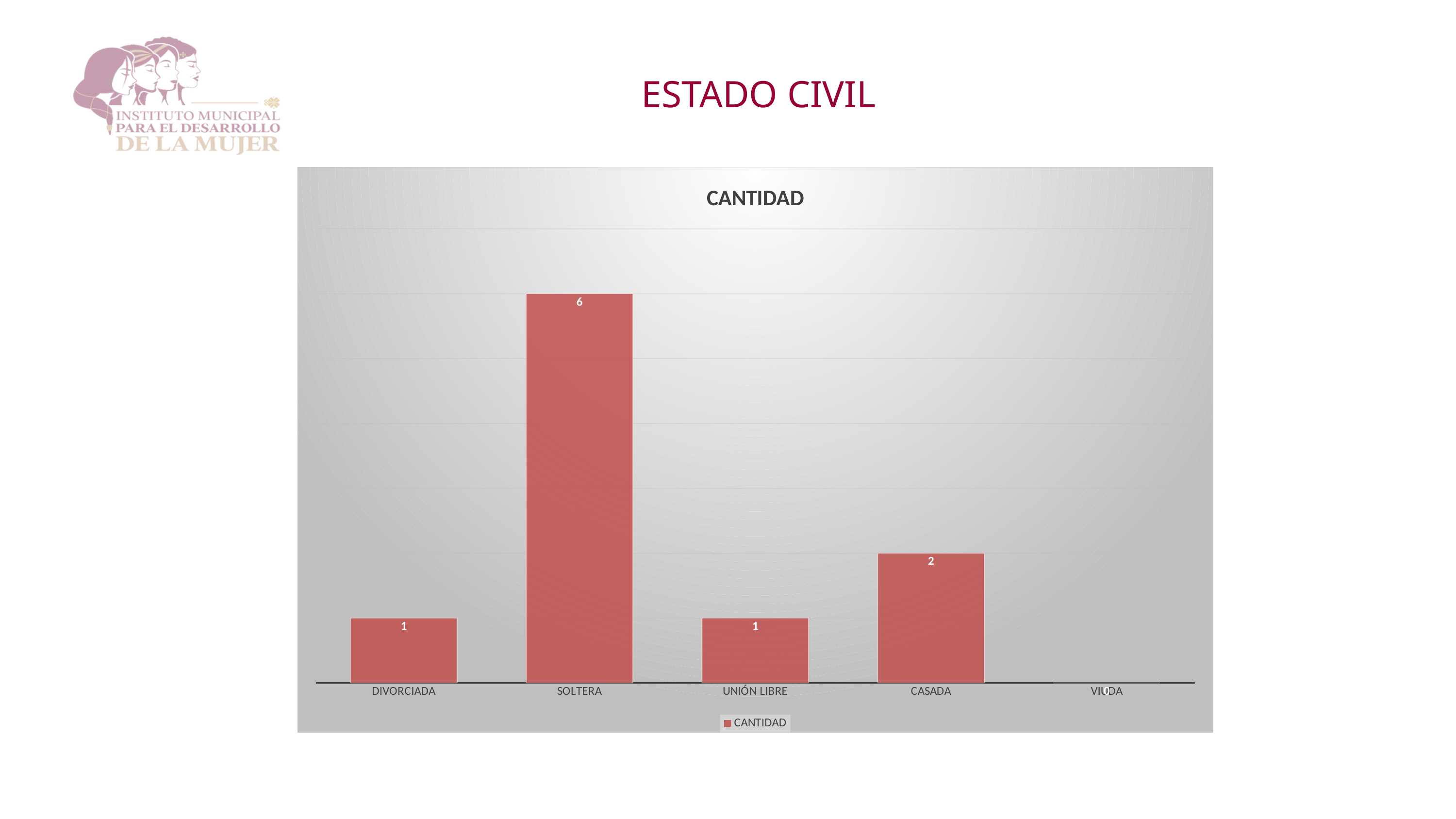
How many categories are shown on the x axis? 5 Which category has the highest value? SOLTERA Which is larger, the value for CASADA or the value for UNIÓN LIBRE? CASADA Which category has the lowest value? VIUDA What is the difference between the values for SOLTERA and CASADA? 4 What is the value for CASADA? 2 What is the value for DIVORCIADA? 1 What is the title of the chart? CANTIDAD What kind of chart is shown? bar chart What is the value for VIUDA? 0 How many series does the legend list? 1 What is the value for SOLTERA? 6